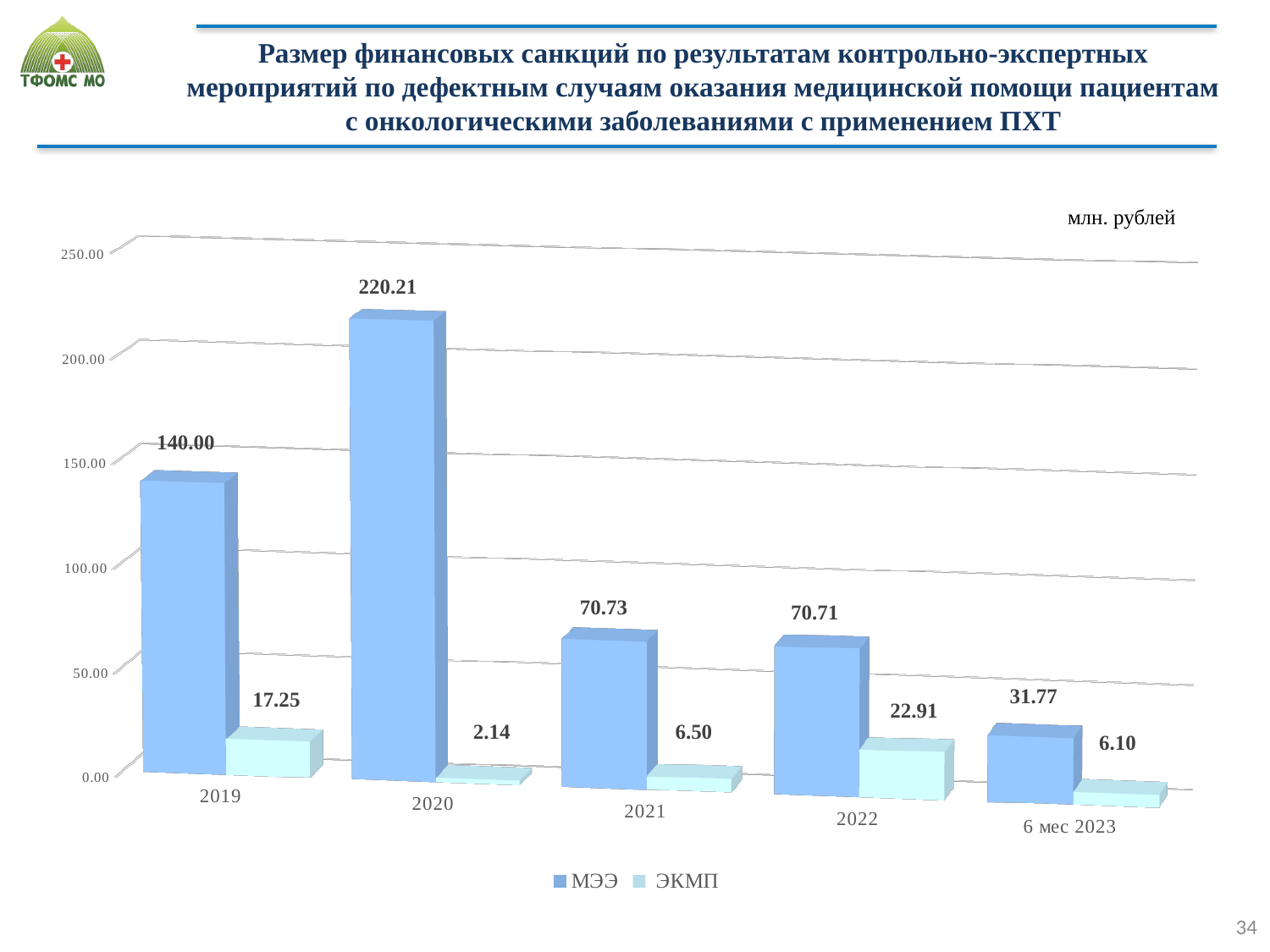
How many categories are shown on the x axis? 5 Which category has the lowest value for ЭКМП? 2020 What is the value for МЭЭ in 2020? 220.21 Which is larger, the ЭКМП value for 2019 or for 2021? 2019 What kind of chart is shown on the slide? bar chart What is the value for ЭКМП in 2022? 22.91 Is the value for МЭЭ in 2021 greater or less than 100.00? less What is the difference between the МЭЭ values for 2020 and 2019? 80.21 What is the value for МЭЭ in 6 мес 2023? 31.77 What unit is indicated above the chart? млн. рублей Which year has the highest value for МЭЭ? 2020 How many series does the legend list? 2